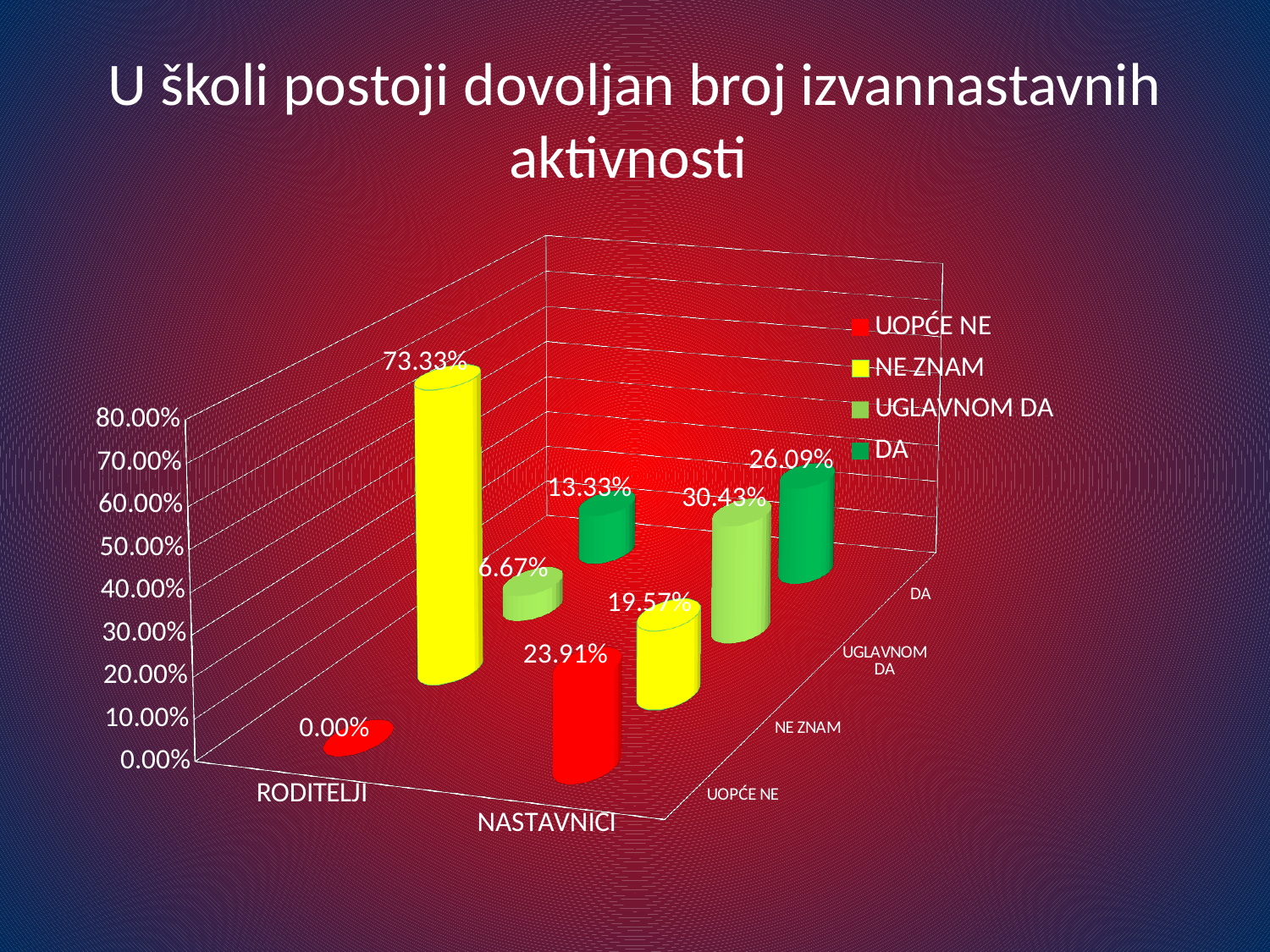
What is the title of the chart? U školi postoji dovoljan broj izvannastavnih aktivnosti What is the value for NE ZNAM among RODITELJI? 73.33% What is the value for UGLAVNOM DA among NASTAVNICI? 30.43% What is the difference between the NE ZNAM values for RODITELJI and NASTAVNICI? 53.76% How many series does the legend list? 4 Which response has the lowest value among RODITELJI? UOPĆE NE What is the value for UOPĆE NE among RODITELJI? 0.00% What is the value for UOPĆE NE among NASTAVNICI? 23.91% Which is larger: the DA value for NASTAVNICI or the DA value for RODITELJI? NASTAVNICI Which response has the highest value among NASTAVNICI? UGLAVNOM DA What is the value for DA among RODITELJI? 13.33% What kind of chart is shown on the slide? bar chart